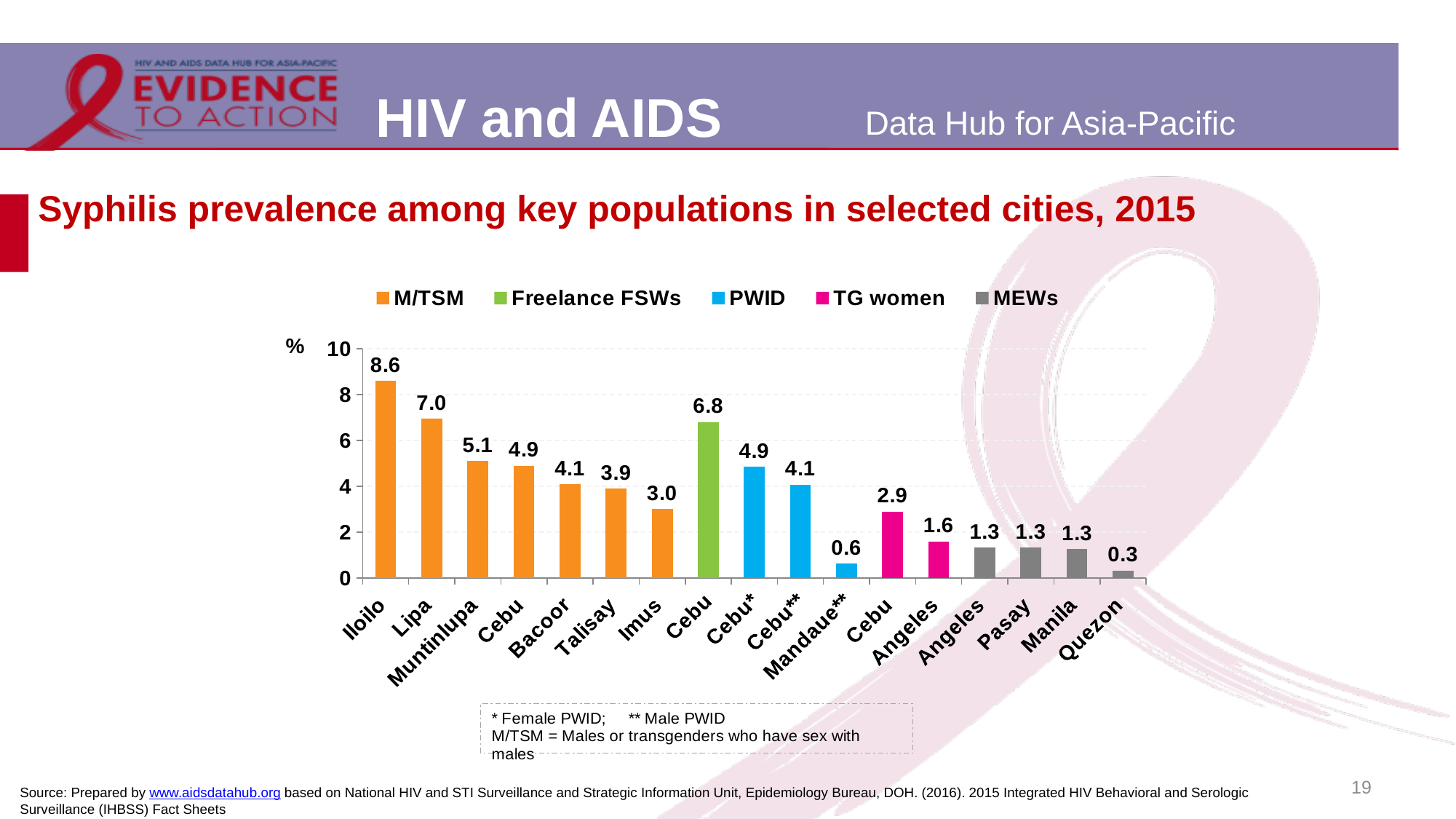
How many bars are plotted on the chart? 17 What is the difference between the M/TSM values for Iloilo and Lipa? 1.6 What is the syphilis prevalence among MEWs in Quezon? 0.3 Which colour represents the PWID series in the chart? Blue Which bar shows the lowest value on the chart? Quezon (MEWs) Which is larger: the M/TSM value for Lipa or the Freelance FSWs value for Cebu? Lipa (M/TSM) What is the syphilis prevalence among Freelance FSWs in Cebu? 6.8 What type of chart is shown on the slide? Bar chart Which city has the highest syphilis prevalence among M/TSM? Iloilo What is the syphilis prevalence among M/TSM in Iloilo? 8.6 How many series does the legend list? 5 What is the syphilis prevalence among male PWID (Mandaue**) in Mandaue? 0.6